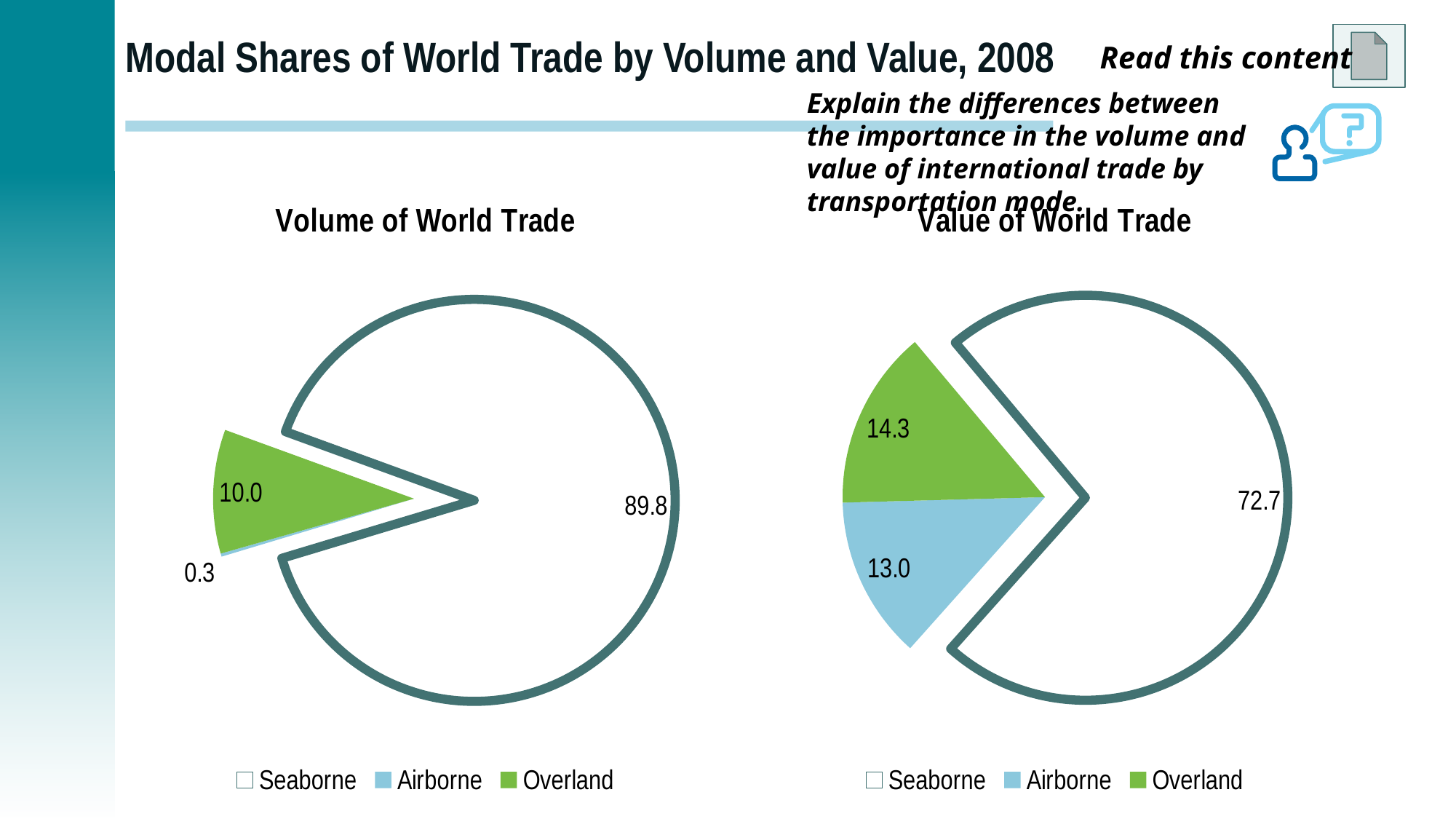
What type of chart is the 'Value of World Trade' chart? Pie chart In the 'Volume of World Trade' chart, which category has the smallest share? Airborne In the 'Value of World Trade' chart, what is the value for Overland? 14.3 In the 'Value of World Trade' chart, what is the value for Airborne? 13.0 In the 'Volume of World Trade' chart, what is the value for Seaborne? 89.8 In the 'Value of World Trade' chart, what is the difference between the Overland and Airborne values? 1.3 Is the Overland share larger in the 'Volume of World Trade' chart or the 'Value of World Trade' chart? Value of World Trade In the 'Volume of World Trade' chart, which category has the largest share? Seaborne In the 'Volume of World Trade' chart, what is the value for Airborne? 0.3 How many categories does the 'Volume of World Trade' chart show? 3 What is the difference between the Seaborne values in the 'Volume of World Trade' chart and the 'Value of World Trade' chart? 17.1 In the 'Value of World Trade' chart, which category has the smallest share? Airborne